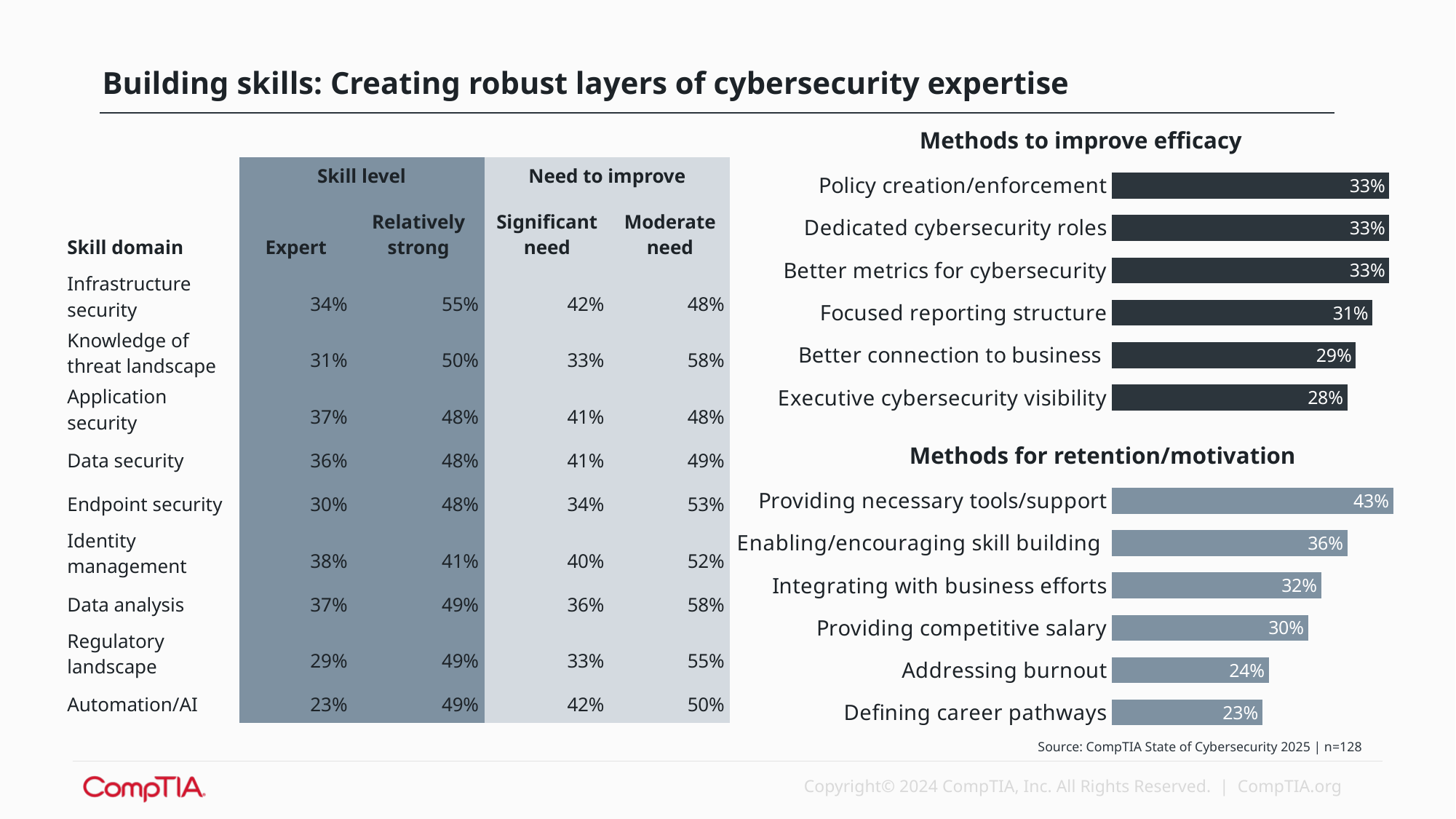
In the 'Methods for retention/motivation' chart, what is the difference between Providing necessary tools/support and Addressing burnout? 19% In the 'Methods for retention/motivation' chart, which is larger: Enabling/encouraging skill building or Integrating with business efforts? Enabling/encouraging skill building In the 'Methods for retention/motivation' chart, which category has the highest value? Providing necessary tools/support In the 'Methods to improve efficacy' chart, what is the difference between Policy creation/enforcement and Better connection to business? 4% In the 'Methods to improve efficacy' chart, how many categories are shown? 6 In the 'Methods to improve efficacy' chart, which category has the lowest value? Executive cybersecurity visibility What type of chart is 'Methods for retention/motivation'? Bar chart In the 'Methods to improve efficacy' chart, what is the value for Executive cybersecurity visibility? 28% In the 'Methods to improve efficacy' chart, what is the value for Focused reporting structure? 31% In the 'Methods for retention/motivation' chart, how many categories are shown? 6 In the 'Methods for retention/motivation' chart, what is the value for Providing competitive salary? 30% In the 'Methods for retention/motivation' chart, which category has the lowest value? Defining career pathways